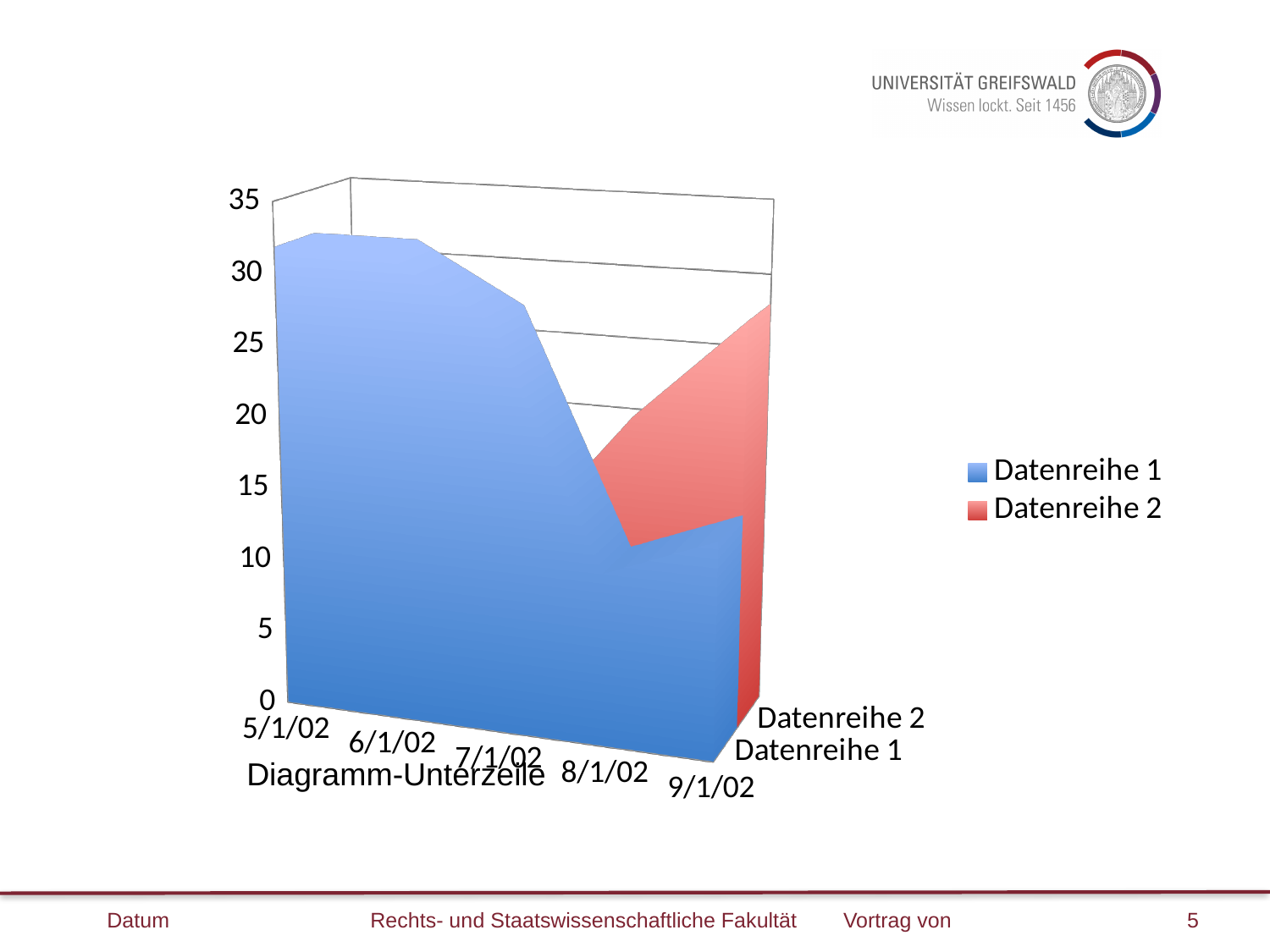
Which colour represents Datenreihe 2? red What are the two series named in the legend? Datenreihe 1 and Datenreihe 2 For Datenreihe 1, which is larger: the value at 5/1/02 or the value at 8/1/02? 5/1/02 Does Datenreihe 1 rise or fall from 5/1/02 to 8/1/02? fall How many dates are shown along the x axis? 5 Is the value of Datenreihe 1 at 7/1/02 greater or less than 20? greater Is the value of Datenreihe 1 at 9/1/02 greater or less than 20? less How many series does the legend list? 2 What kind of chart is shown on the slide? area chart Is the value of Datenreihe 1 at 8/1/02 greater or less than 15? less What is the highest value shown on the vertical axis? 35